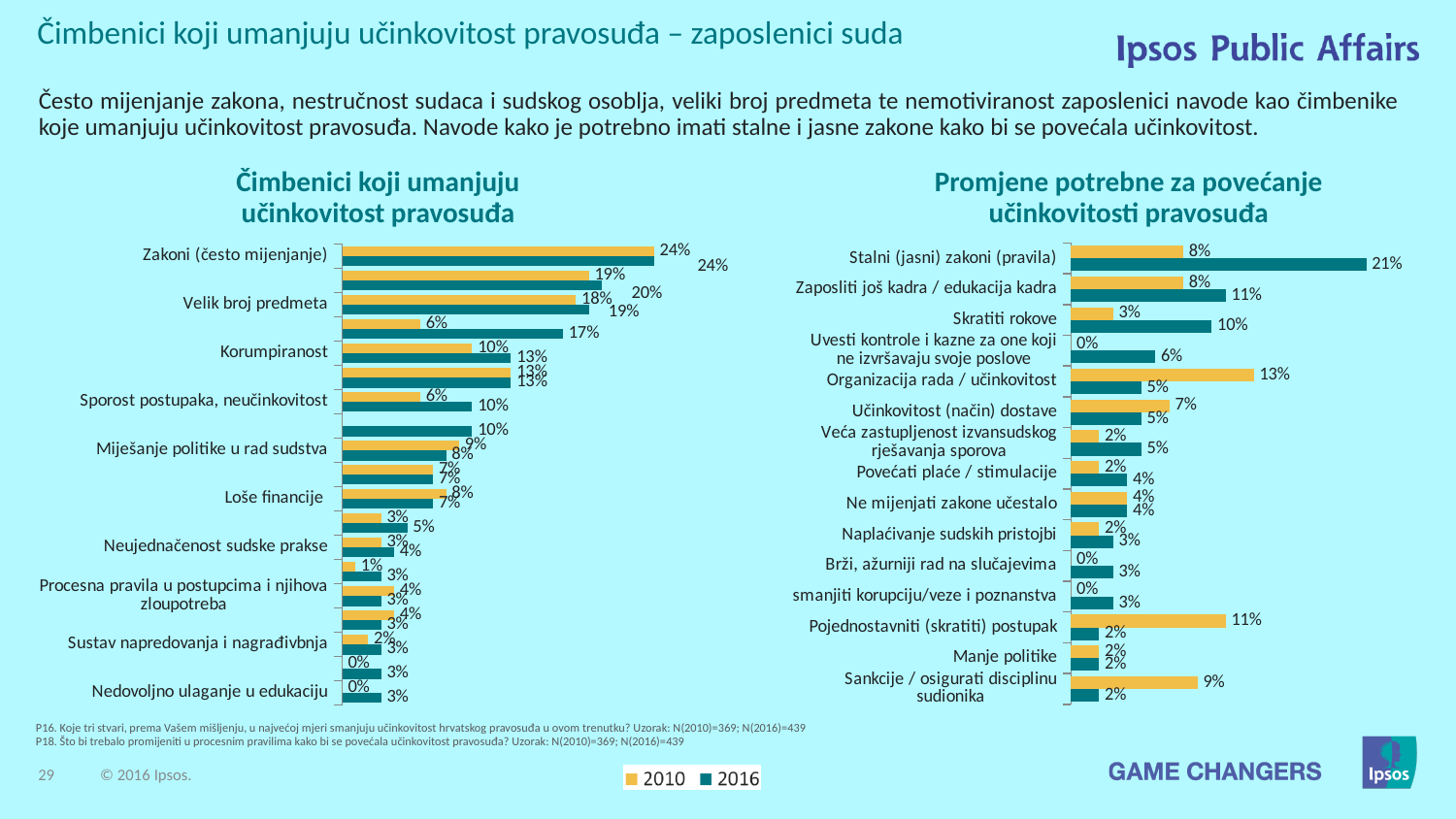
How many categories are shown in the chart 'Promjene potrebne za povećanje učinkovitosti pravosuđa'? 15 In the chart 'Čimbenici koji umanjuju učinkovitost pravosuđa', what is the 2016 value for 'Zakoni (često mijenjanje)'? 24% In the chart 'Promjene potrebne za povećanje učinkovitosti pravosuđa', what is the 2010 value for 'Organizacija rada / učinkovitost'? 13% In the chart 'Promjene potrebne za povećanje učinkovitosti pravosuđa', which category has the highest 2016 value? Stalni (jasni) zakoni (pravila) In the chart 'Promjene potrebne za povećanje učinkovitosti pravosuđa', by how many percentage points did 'Stalni (jasni) zakoni (pravila)' increase from 2010 to 2016? 13 percentage points In the chart 'Promjene potrebne za povećanje učinkovitosti pravosuđa', which category has the highest 2010 value? Organizacija rada / učinkovitost In the chart 'Promjene potrebne za povećanje učinkovitosti pravosuđa', for 'Pojednostavniti (skratiti) postupak', which year has the larger value, 2010 or 2016? 2010 What are the two series named in the legend on this slide? 2010 and 2016 In the chart 'Promjene potrebne za povećanje učinkovitosti pravosuđa', what is the 2016 value for 'Stalni (jasni) zakoni (pravila)'? 21% What type of chart is 'Čimbenici koji umanjuju učinkovitost pravosuđa'? Bar chart In the chart 'Promjene potrebne za povećanje učinkovitosti pravosuđa', what is the 2016 value for 'Skratiti rokove'? 10% How many series does the legend list for the charts on this slide? 2